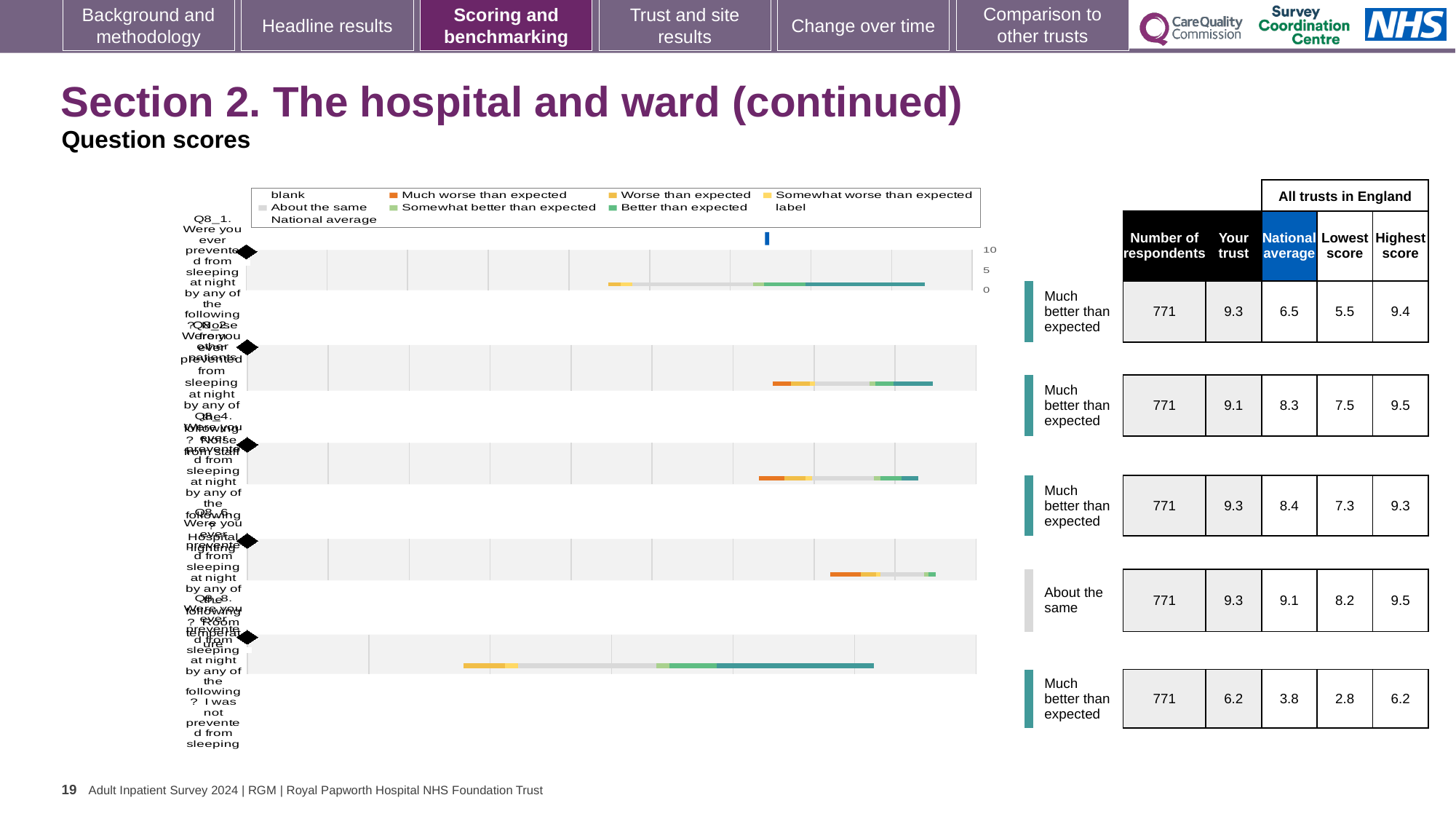
What kind of chart is shown on the left of the slide? bar chart How many respondents are listed for each row in the table? 771 For the second row, which is larger: 'Your trust' or 'National average'? Your trust What is the highest value shown on the chart's axis? 10 Which row has the lowest 'Your trust' score in the table? the fifth (bottom) row How many rows are rated 'Much better than expected'? 4 In the table, what is the 'National average' for the second row? 8.3 How many question rows (bars) are plotted in the chart? 5 In the table, what is the 'Lowest score' for the fifth (bottom) row? 2.8 What is the difference between 'Your trust' and 'National average' for the fifth (bottom) row? 2.4 In the table, what is the 'Your trust' score for the first row? 9.3 In the table, what is the 'Highest score' for the fourth row? 9.5